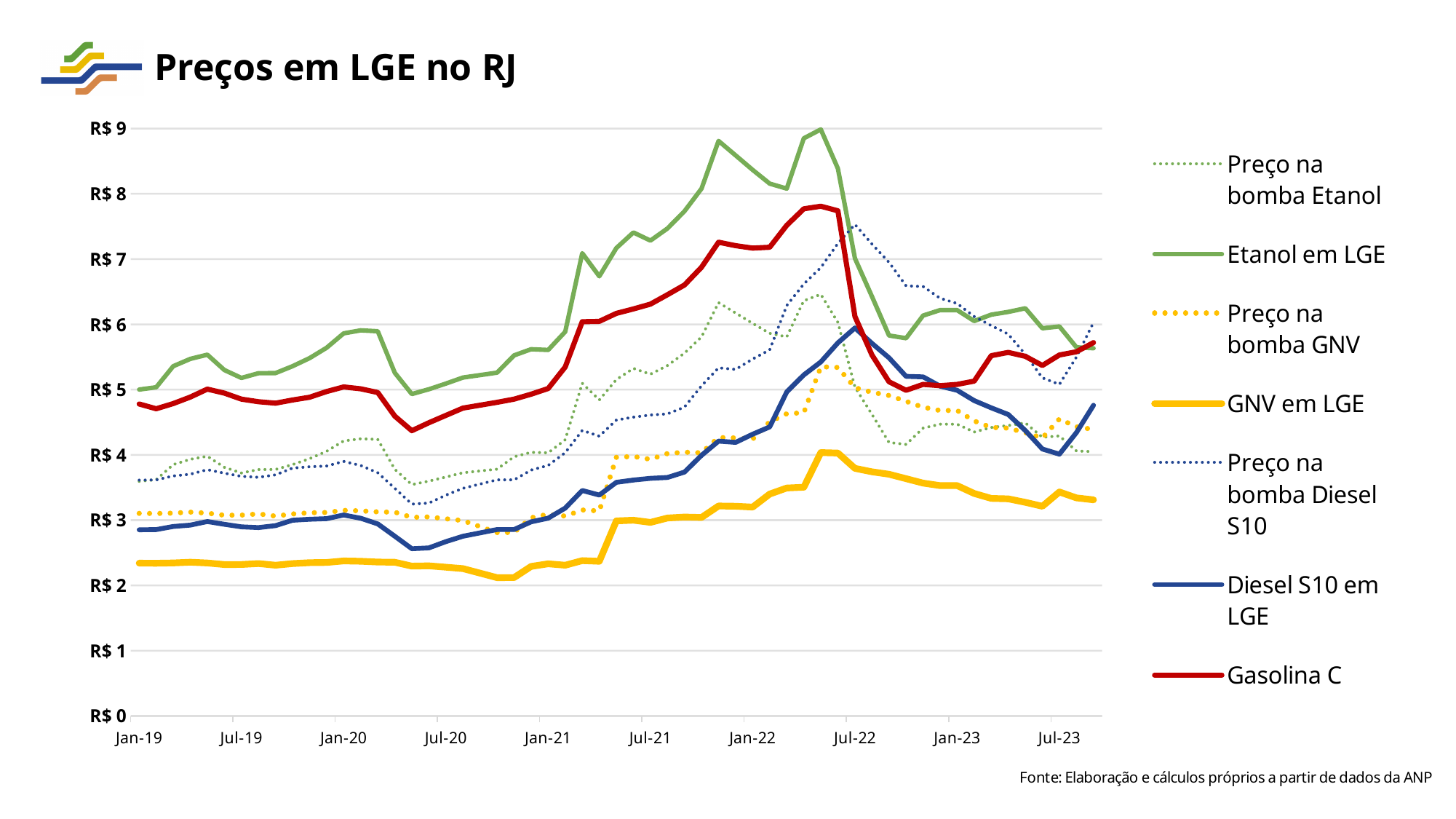
Is the value of Gasolina C at Jan-22 greater or less than R$ 6? greater Does the GNV em LGE series rise or fall from Jan-19 to Jul-22? rise How many series does the legend list? 7 At Jan-22, which is higher, Etanol em LGE or Gasolina C? Etanol em LGE Which series reaches the highest value on the chart? Etanol em LGE What kind of chart is shown on the slide? line chart Which series has the lowest values across the whole period? GNV em LGE Is the value of GNV em LGE at Jan-19 greater or less than R$ 3? less How many labelled dates are shown on the x axis? 10 Is the value of Etanol em LGE at Jan-19 greater or less than R$ 6? less What is the title of the chart? Preços em LGE no RJ